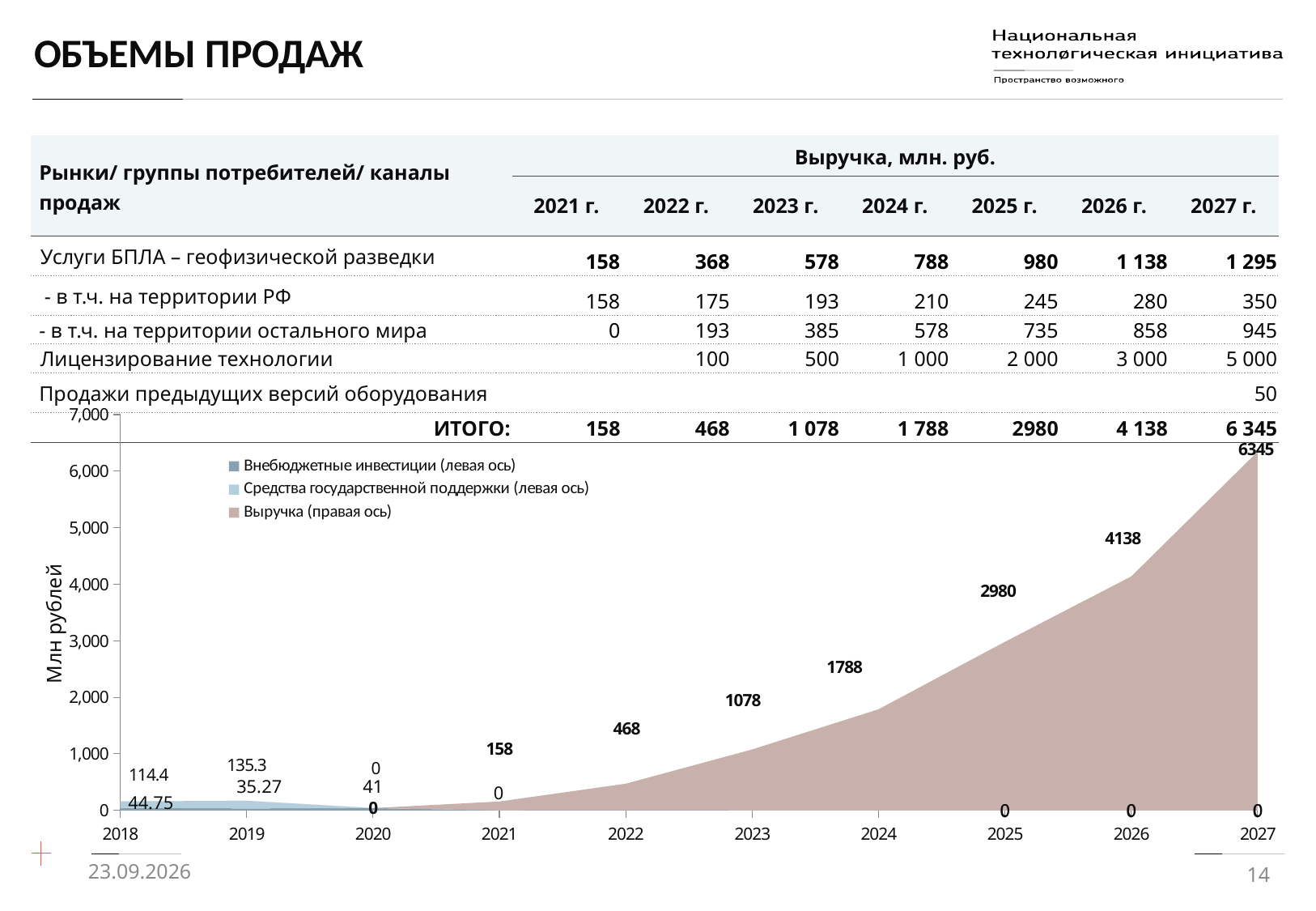
How many series does the chart legend list? 3 Which is larger on the chart: Выручка for 2024 or for 2023? 2024 In which year is Выручка (правая ось) highest on the chart? 2027 What kind of chart is shown on the slide? area chart What is the value of Выручка (правая ось) for 2027 on the chart? 6345 Does Выручка (правая ось) rise or fall from 2021 to 2027 on the chart? rise What is the value of Выручка (правая ось) for 2022 on the chart? 468 How many years are shown along the x axis of the chart? 10 What is the title of the vertical axis of the chart? Млн рублей What is the difference between Выручка for 2027 and 2026 on the chart? 2207 Which legend entry is listed first in the chart? Внебюджетные инвестиции (левая ось) What is the value of Выручка (правая ось) for 2025 on the chart? 2980